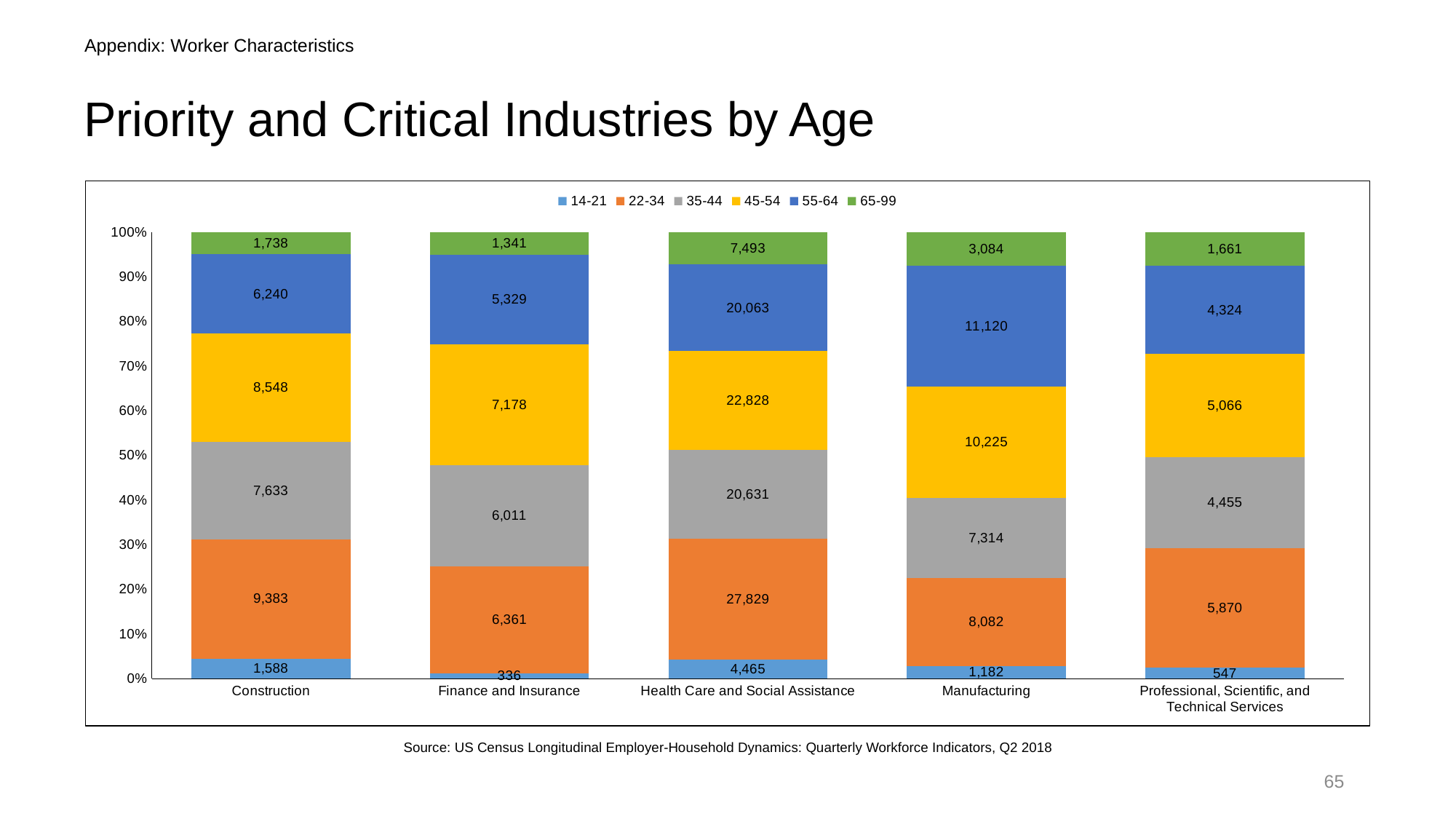
Which industry has the highest value for the 45-54 age group? Health Care and Social Assistance What is the value for the 55-64 age group in Manufacturing? 11,120 What is the difference between the 22-34 and 35-44 values in Health Care and Social Assistance? 7,198 What is the value for the 14-21 age group in Finance and Insurance? 336 What is the total of all age groups for the Construction bar? 35,130 Which industry has the lowest value for the 14-21 age group? Finance and Insurance What is the value for the 22-34 age group in Health Care and Social Assistance? 27,829 Which is larger in Manufacturing: the 45-54 value or the 55-64 value? 55-64 How many industries are shown on the x axis? 5 What kind of chart is shown on the slide? 100% stacked bar chart What is the value for the 65-99 age group in Professional, Scientific, and Technical Services? 1,661 How many age groups does the legend list? 6